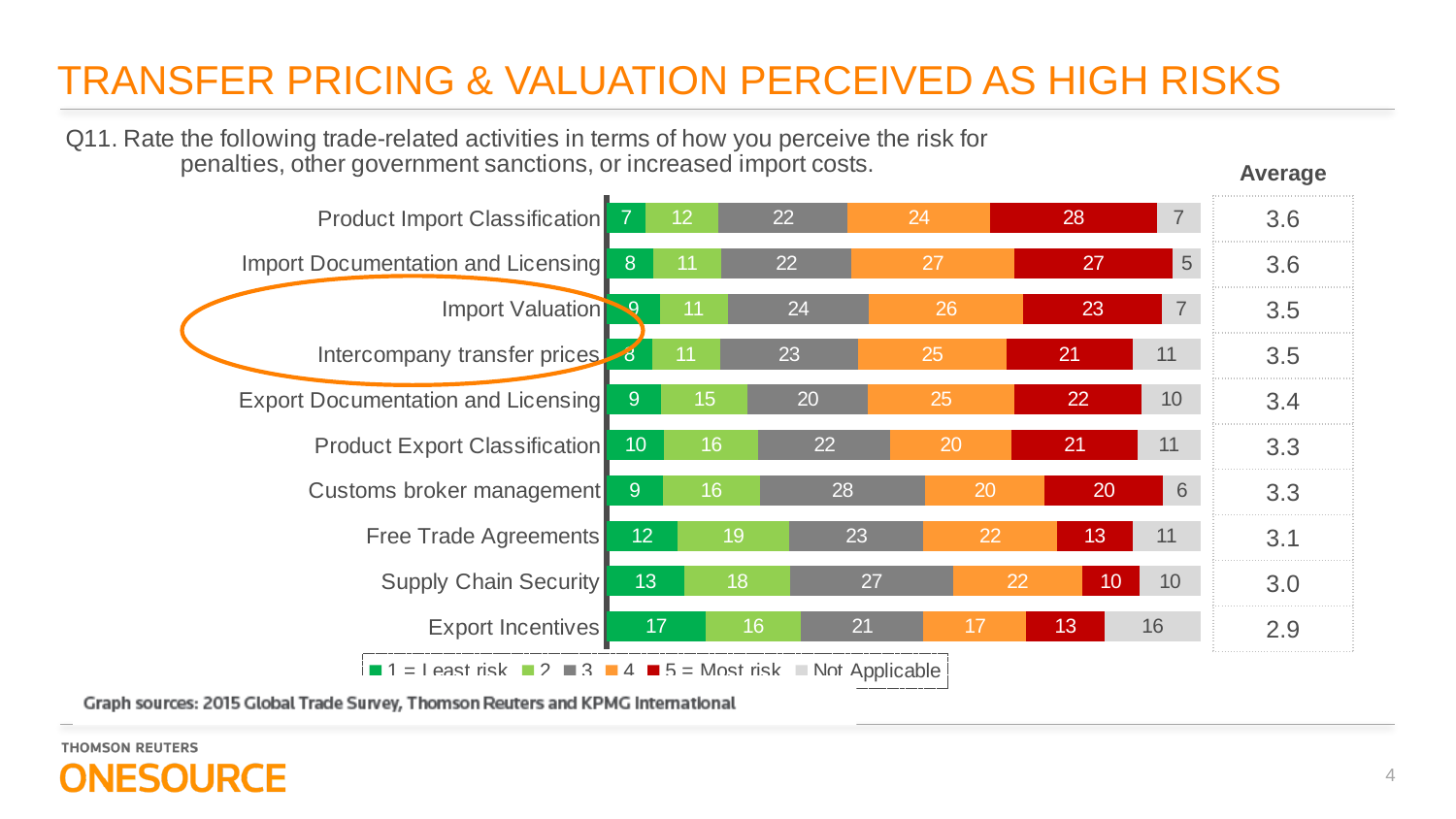
Which has a larger "3" segment value: Customs broker management or Export Documentation and Licensing? Customs broker management What kind of chart is shown on the slide? Stacked bar chart How many series does the chart legend list? 6 What is the Average shown for Export Incentives? 2.9 Which activity has the lowest "5 = Most risk" value? Supply Chain Security What is the difference between the "4" segment values for Import Documentation and Licensing and Product Export Classification? 7 How many trade-related activities (categories) are plotted in the chart? 10 What is the total of all segments in the Product Import Classification bar? 100 What is the value of the "1 = Least risk" segment for Export Incentives? 17 What is the value of the "5 = Most risk" segment for Product Import Classification? 28 Which activity has the highest "5 = Most risk" value? Product Import Classification What is the "Not Applicable" value for Import Documentation and Licensing? 5